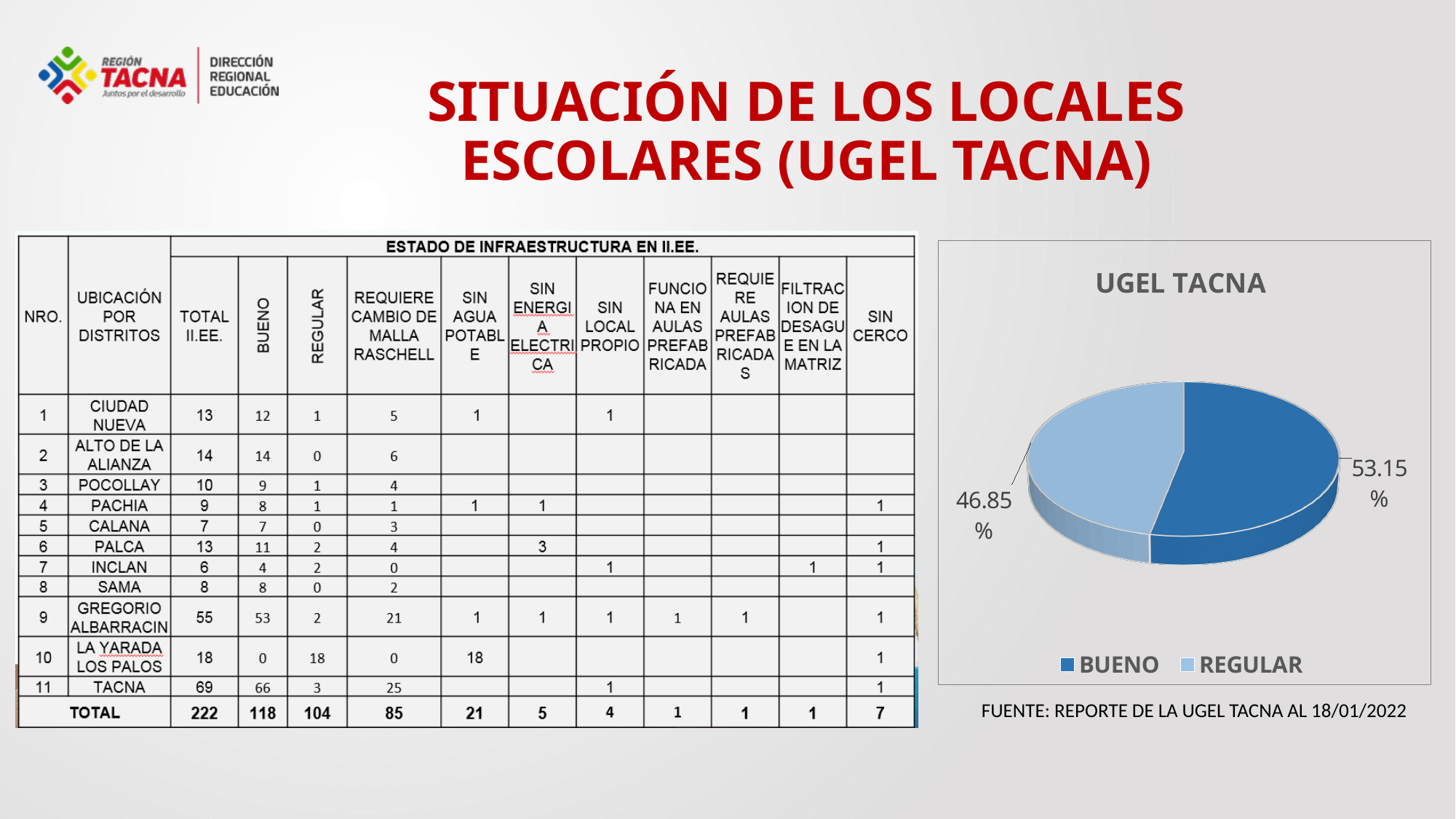
Which is larger in the pie chart, BUENO or REGULAR? BUENO What percentage of the pie chart is BUENO? 53.15% Is the share of the BUENO slice greater or less than 50%? greater What percentage of the pie chart is REGULAR? 46.85% What is the difference in percentage points between the BUENO and REGULAR slices? 6.3 How many entries does the pie chart legend list? 2 What is the title of the pie chart? UGEL TACNA Which slice of the pie chart is the largest? BUENO What kind of chart is shown on the slide? pie chart Which slice of the pie chart is the smallest? REGULAR Which legend entry of the pie chart is shown in the lighter blue colour? REGULAR How many slices does the pie chart have? 2